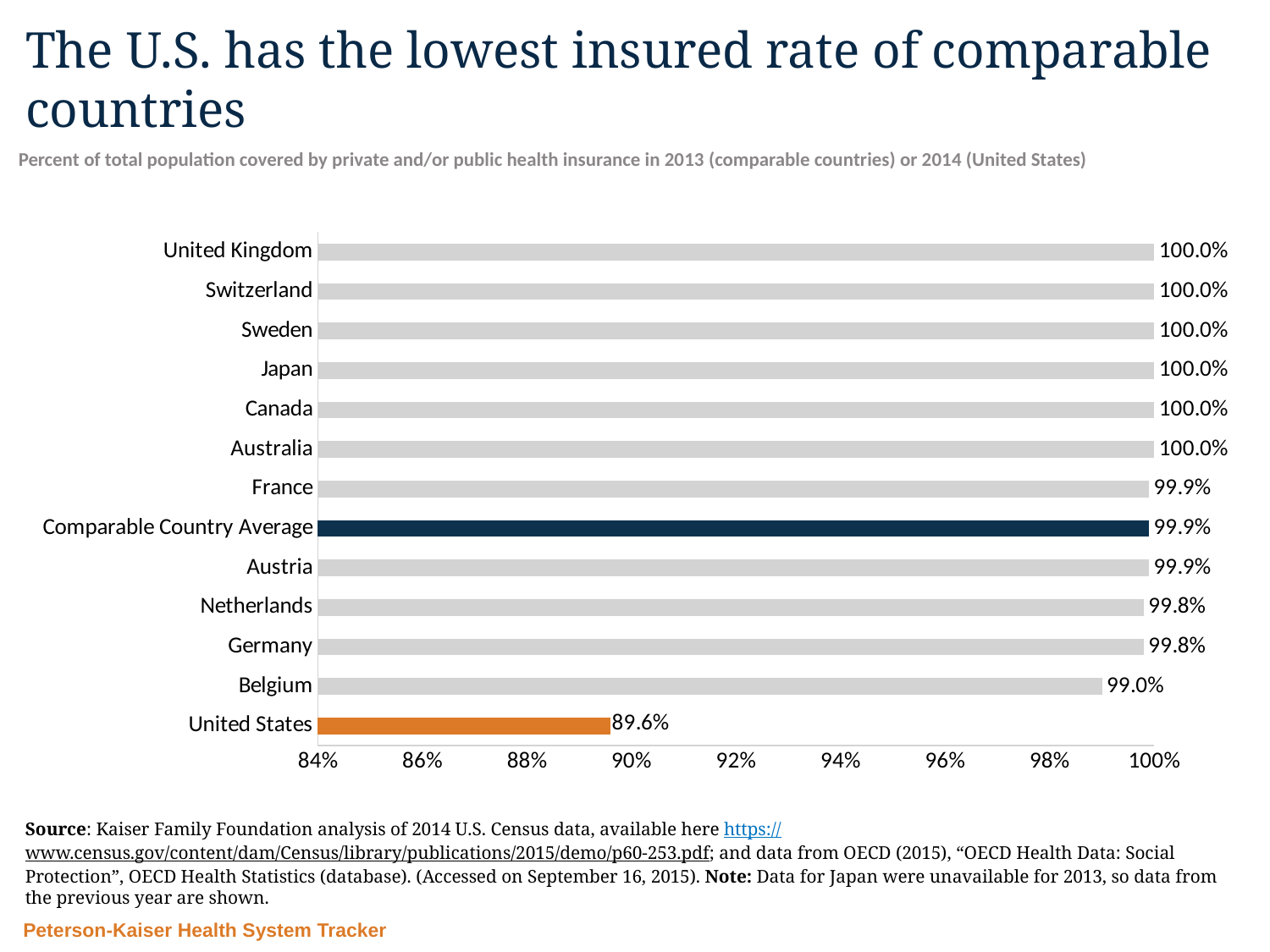
What is the insured rate for Belgium? 99.0% What kind of chart is shown on the slide? Bar chart Is the value for the United States greater or less than 90%? less What is the difference between the Comparable Country Average and the United States? 10.3% What is the value for the Comparable Country Average? 99.9% What colour is the bar for the United States? Orange What is the insured rate for the United States? 89.6% What is the insured rate for Germany? 99.8% Which category has the lowest insured rate? United States What is the difference between Belgium and the United States? 9.4% How many categories (bars) are shown in the chart? 13 Which has a higher insured rate, Belgium or the Netherlands? Netherlands